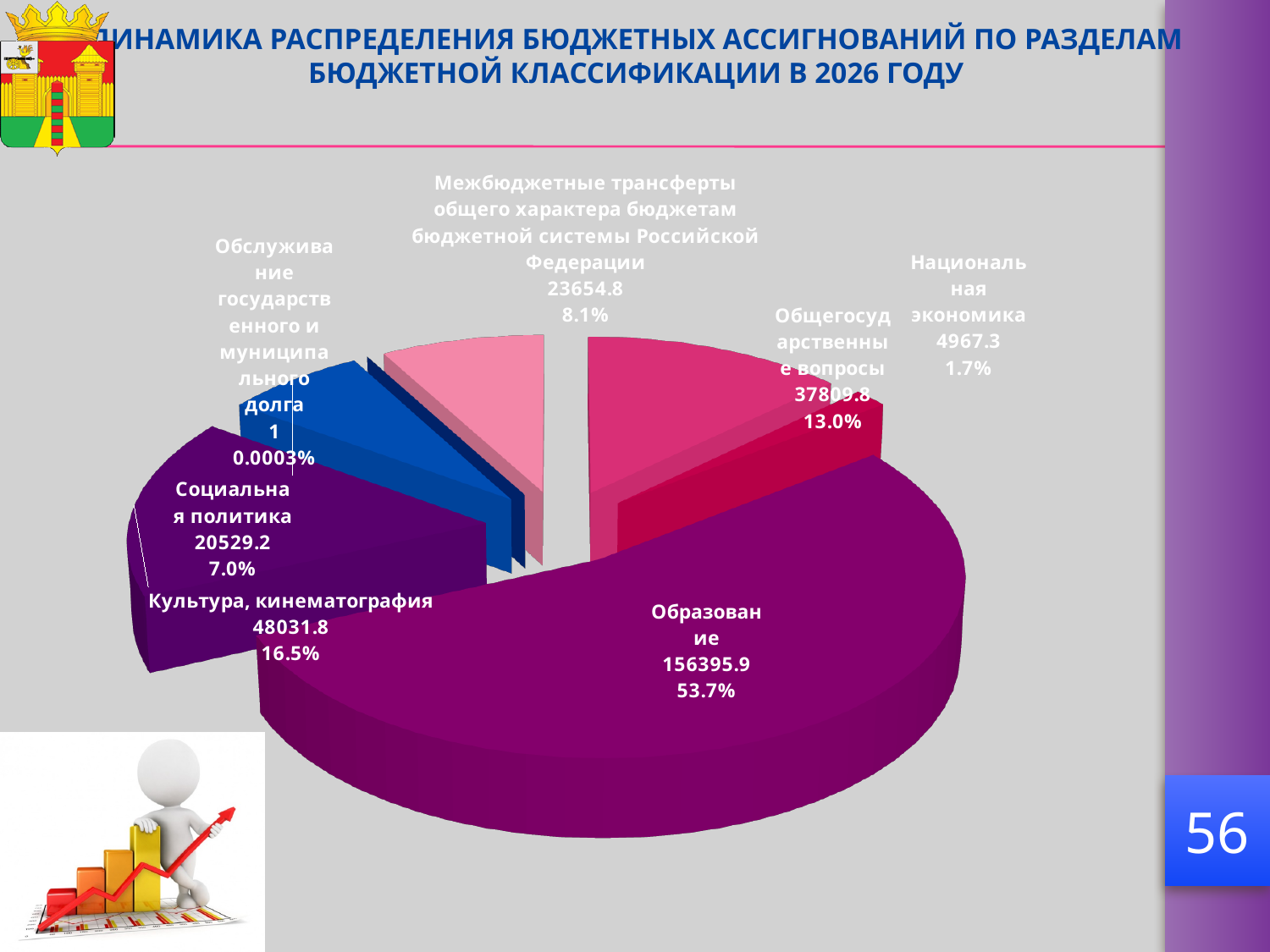
Which category has the largest slice of the pie? Образование What percentage is shown for Социальная политика? 7.0% What value is shown for Культура, кинематография? 48031.8 Which category has the smallest slice of the pie? Обслуживание государственного и муниципального долга Which is larger, the value for Социальная политика or the value for Межбюджетные трансферты общего характера бюджетам бюджетной системы Российской Федерации? Межбюджетные трансферты общего характера бюджетам бюджетной системы Российской Федерации What share of the pie does Образование represent? 53.7% What kind of chart is shown on the slide? pie chart What value is shown for Национальная экономика? 4967.3 What is the difference between the values for Культура, кинематография and Общегосударственные вопросы? 10222.0 What percentage is shown for Общегосударственные вопросы? 13.0% What value is shown for Образование? 156395.9 How many slices does the pie chart have? 7